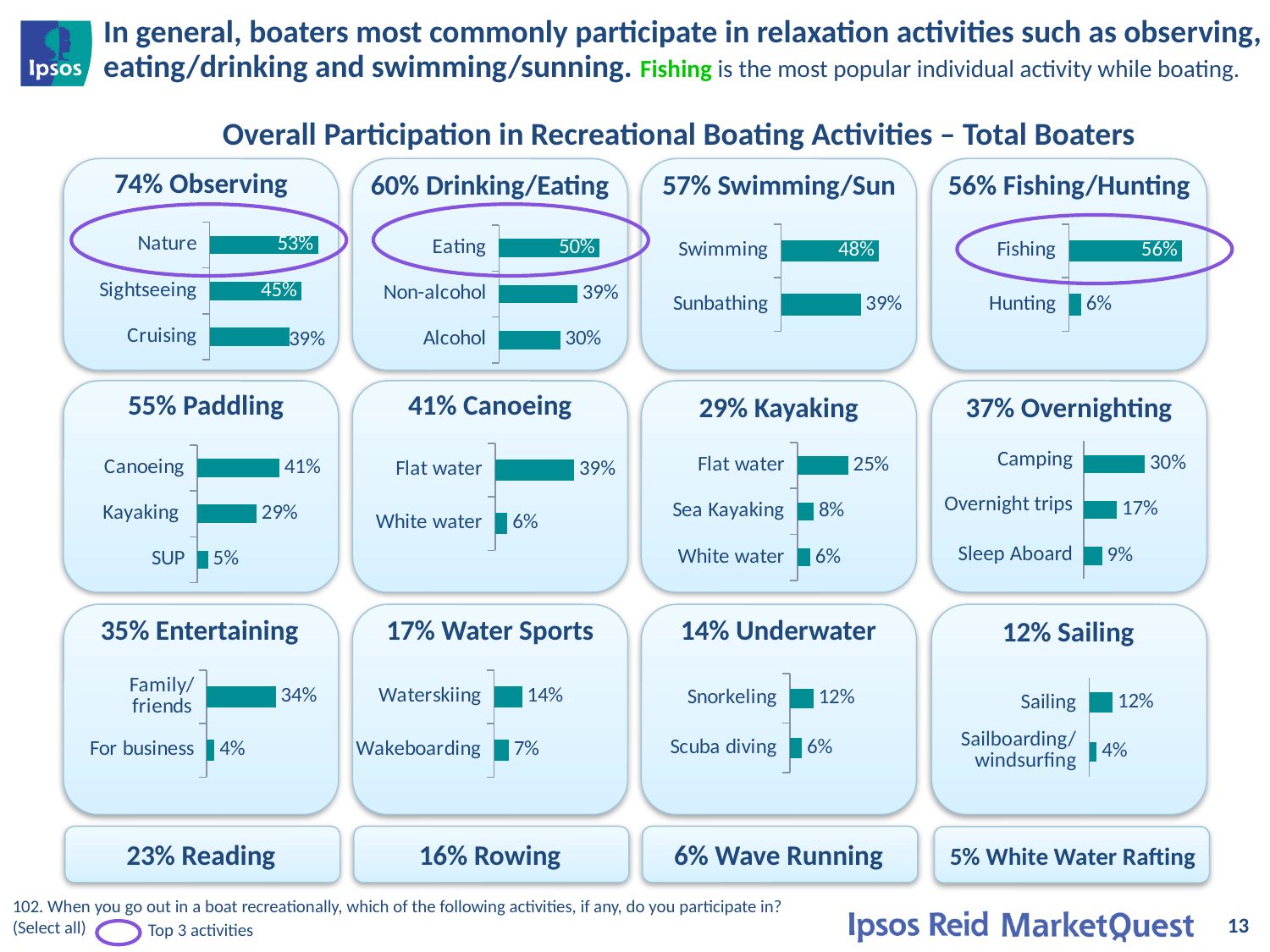
In the '55% Paddling' chart, how many categories are shown? 3 In the '57% Swimming/Sun' chart, what is the difference between Swimming and Sunbathing? 9% In the '60% Drinking/Eating' chart, which category has the lowest value? Alcohol In the '35% Entertaining' chart, what is the difference between Family/friends and For business? 30% What type of chart is used in the '14% Underwater' panel? Bar chart In the '12% Sailing' chart, what is the value for Sailboarding/windsurfing? 4% In the '56% Fishing/Hunting' chart, what is the value for Hunting? 6% In the '41% Canoeing' chart, which is larger, Flat water or White water? Flat water In the '29% Kayaking' chart, what is the value for Sea Kayaking? 8% In the '74% Observing' chart, what is the value for Sightseeing? 45% In the '37% Overnighting' chart, which category has the highest value? Camping In the '17% Water Sports' chart, what is the value for Wakeboarding? 7%